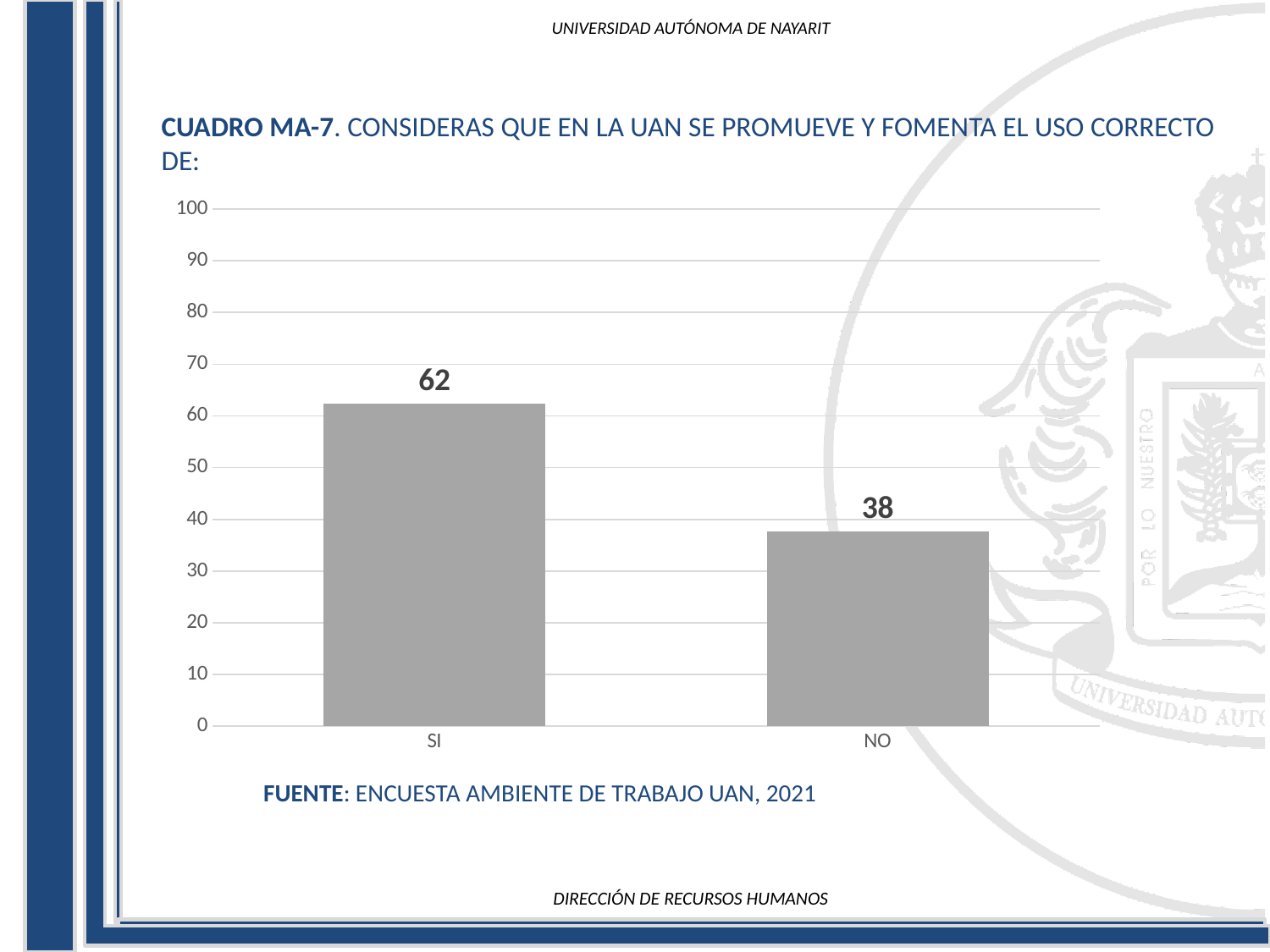
What is the difference between the values for SI and NO? 24 What is the total of the two values shown? 100 Which category has the highest value? SI What is the value for SI? 62 What is the value for NO? 38 Which category has the lowest value? NO Is the value for NO greater or less than 40? less What source is cited below the chart? ENCUESTA AMBIENTE DE TRABAJO UAN, 2021 How many categories are shown on the x axis? 2 What kind of chart is shown on the slide? bar chart Is the value for SI greater or less than 60? greater Which is larger, the value for SI or the value for NO? SI